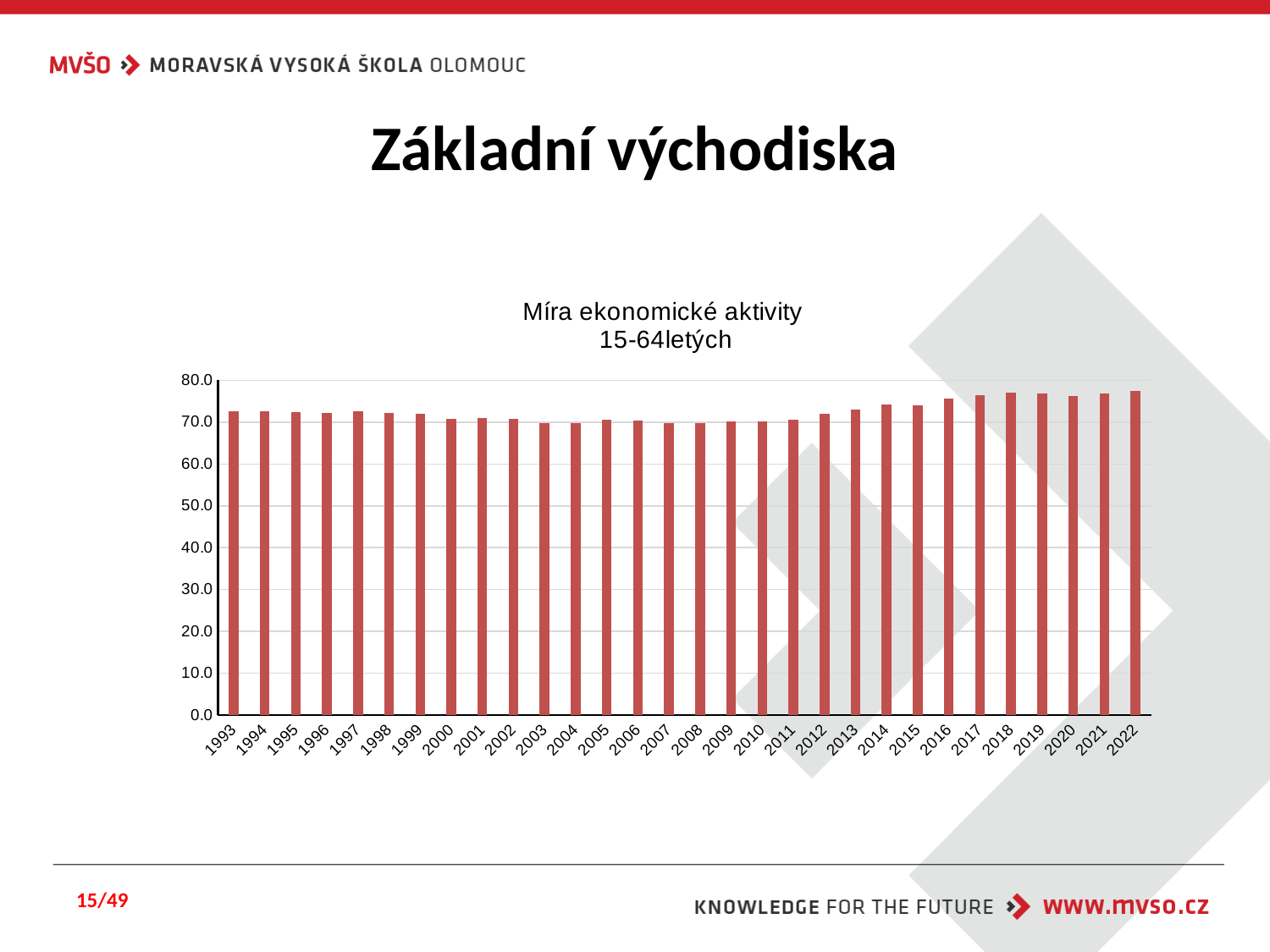
What kind of chart is shown on the slide? bar chart How many years (bars) are plotted on the chart? 30 Do the values rise or fall from 2013 to 2022? rise Is the value for 2010 greater or less than 80? less What is the first year shown on the x axis? 1993 Which is larger, the value for 2022 or the value for 1993? 2022 What is the title of the chart? Míra ekonomické aktivity 15-64letých Is the value for 1993 greater or less than 80? less Which is larger, the value for 2010 or the value for 2017? 2017 Do the values rise or fall from 1993 to 2004? fall Is the value for 2018 greater or less than 70? greater